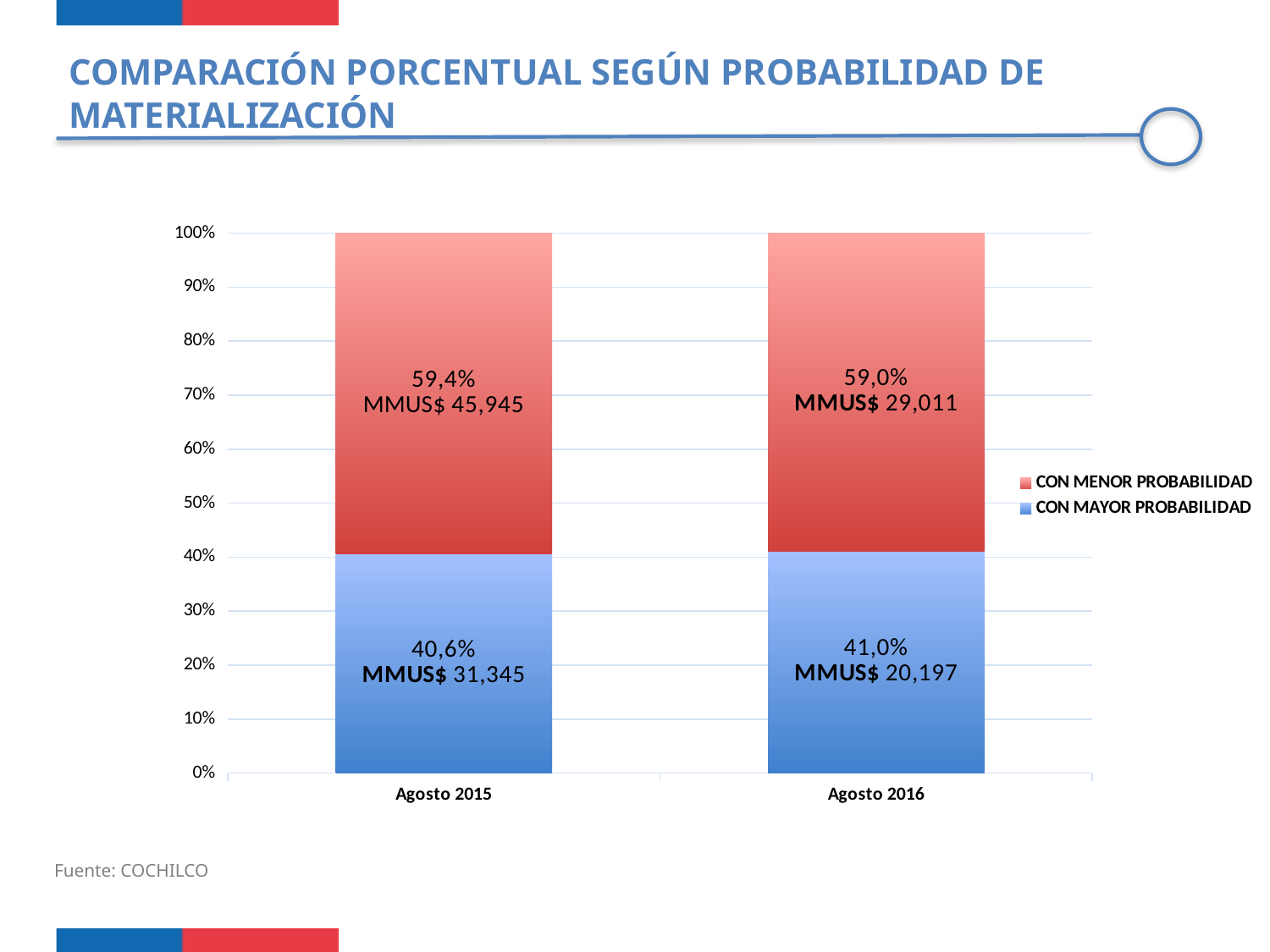
What is the difference in percentage points between the CON MENOR PROBABILIDAD share and the CON MAYOR PROBABILIDAD share in Agosto 2015? 18,8 How many series does the legend list? 2 Is the CON MAYOR PROBABILIDAD share in Agosto 2015 greater or less than 50%? less Does the CON MAYOR PROBABILIDAD share rise or fall from Agosto 2015 to Agosto 2016? rise Which colour represents CON MENOR PROBABILIDAD in the legend? Red What percentage share does CON MAYOR PROBABILIDAD have in Agosto 2016? 41,0% What percentage share does CON MENOR PROBABILIDAD have in Agosto 2015? 59,4% What is the MMUS$ amount labelled for CON MENOR PROBABILIDAD in Agosto 2016? MMUS$ 29,011 What kind of chart is shown on the slide? Stacked bar chart Which series has the larger share in Agosto 2016, CON MENOR PROBABILIDAD or CON MAYOR PROBABILIDAD? CON MENOR PROBABILIDAD How many categories are shown on the x axis? 2 What is the MMUS$ amount labelled for CON MAYOR PROBABILIDAD in Agosto 2015? MMUS$ 31,345